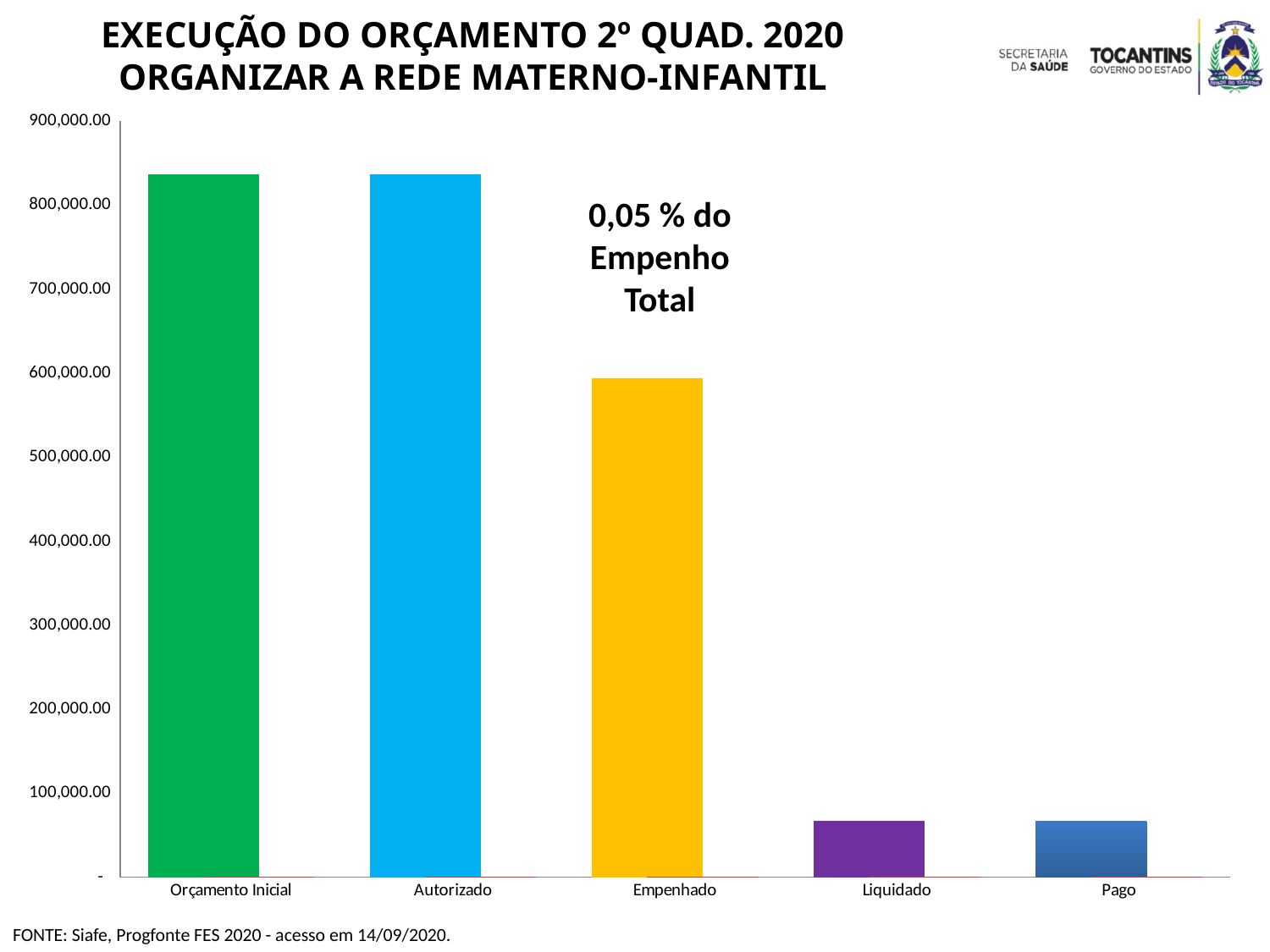
Which is larger, the value for Empenhado or the value for Liquidado? Empenhado Is the value for Autorizado greater or less than 800,000.00? greater What percentage of the total Empenho does the text annotation on the chart state? 0,05 % Which is larger, the value for Autorizado or the value for Empenhado? Autorizado How many categories are shown on the x axis of the chart? 5 Is the value for Pago greater or less than 100,000.00? less Is the value for Empenhado greater or less than 500,000.00? greater Do the values generally rise or fall from Orçamento Inicial to Pago along the x axis? fall What kind of chart is shown on the slide? bar chart